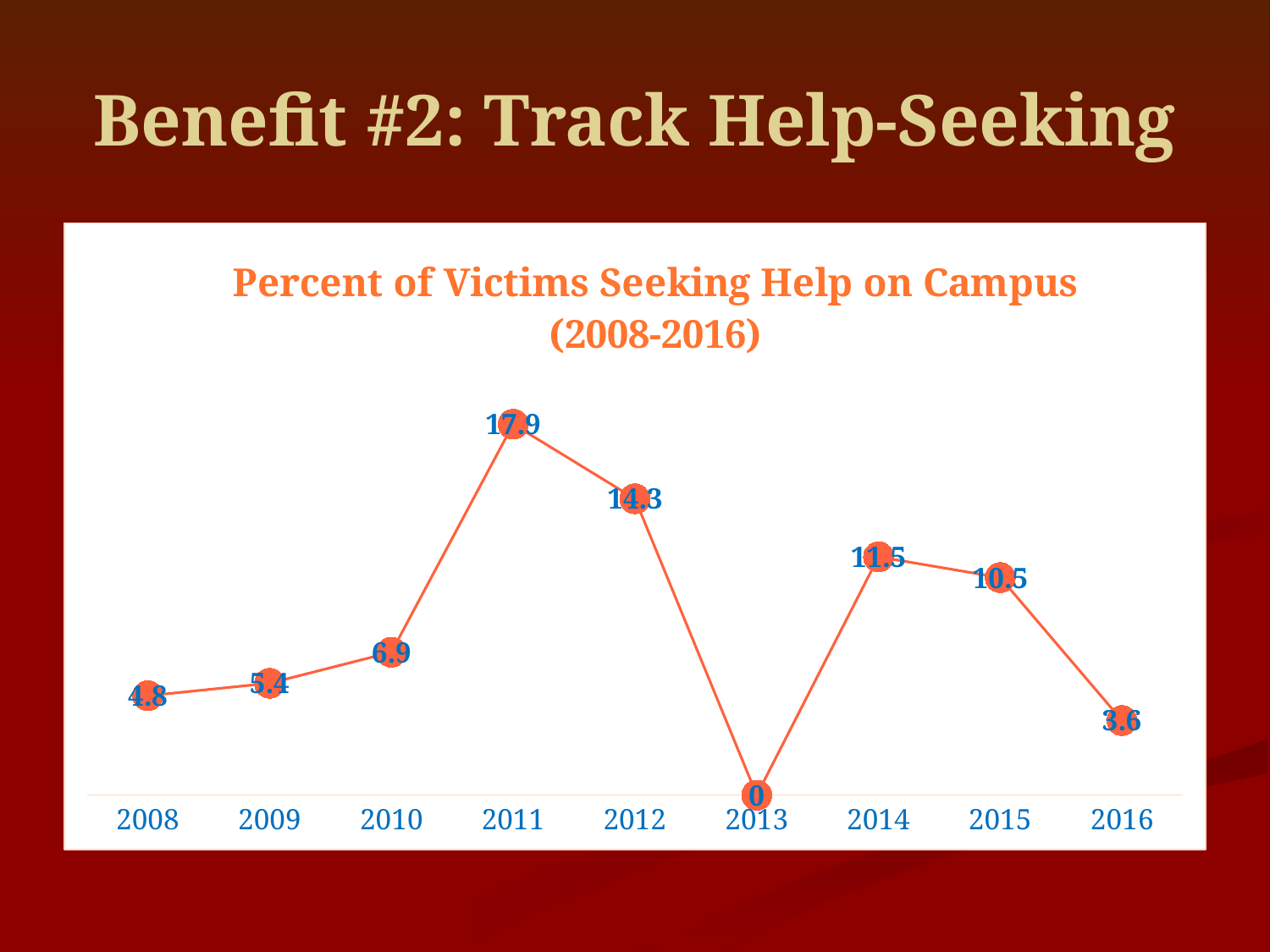
Which is larger, the value for 2010 or the value for 2016? 2010 Which year has the highest value? 2011 What is the value for 2016? 3.6 What is the value for 2013? 0 What is the value for 2011? 17.9 What is the title of the chart? Percent of Victims Seeking Help on Campus (2008-2016) How many years are plotted on the chart? 9 What kind of chart is shown? line chart Which year has the lowest value? 2013 What is the value for 2008? 4.8 What is the difference between the values for 2011 and 2012? 3.6 What is the difference between the values for 2014 and 2015? 1